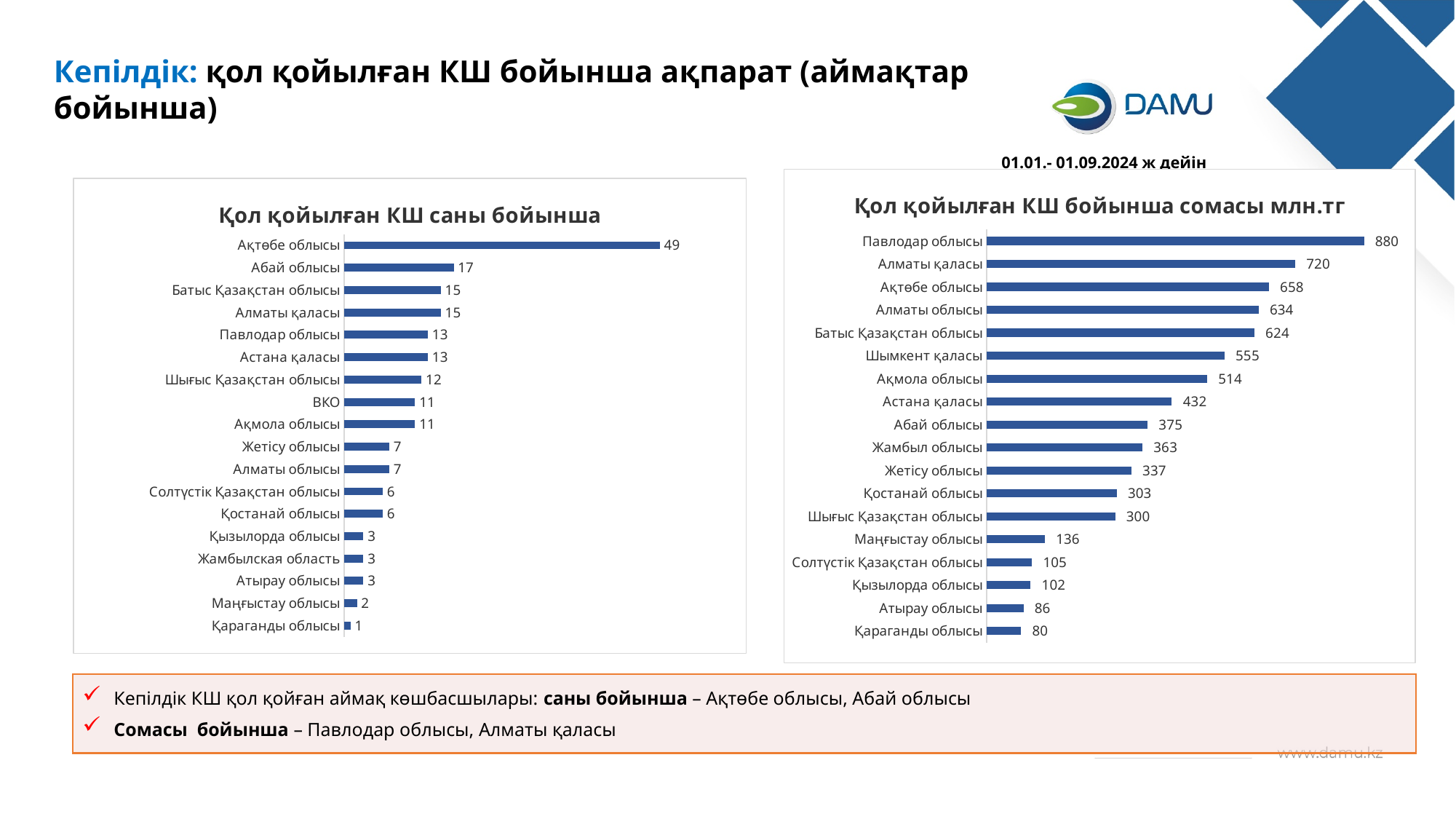
In the chart 'Қол қойылған КШ саны бойынша', which category has the lowest value? Қараганды облысы In the chart 'Қол қойылған КШ бойынша сомасы млн.тг', which category has the highest value? Павлодар облысы In the chart 'Қол қойылған КШ саны бойынша', which category has the highest value? Ақтөбе облысы In the chart 'Қол қойылған КШ бойынша сомасы млн.тг', what is the value for Шымкент қаласы? 555 In the chart 'Қол қойылған КШ саны бойынша', what is the value for Абай облысы? 17 In the chart 'Қол қойылған КШ бойынша сомасы млн.тг', which category has the lowest value? Қараганды облысы In the chart 'Қол қойылған КШ бойынша сомасы млн.тг', what is the difference between Павлодар облысы and Алматы қаласы? 160 In the chart 'Қол қойылған КШ саны бойынша', how many categories are shown? 18 In the chart 'Қол қойылған КШ саны бойынша', what is the difference between Ақтөбе облысы and Абай облысы? 32 What is the title of the chart on the left side of the slide? Қол қойылған КШ саны бойынша In the chart 'Қол қойылған КШ бойынша сомасы млн.тг', which is larger: Ақмола облысы or Астана қаласы? Ақмола облысы What type of chart is 'Қол қойылған КШ бойынша сомасы млн.тг'? Bar chart